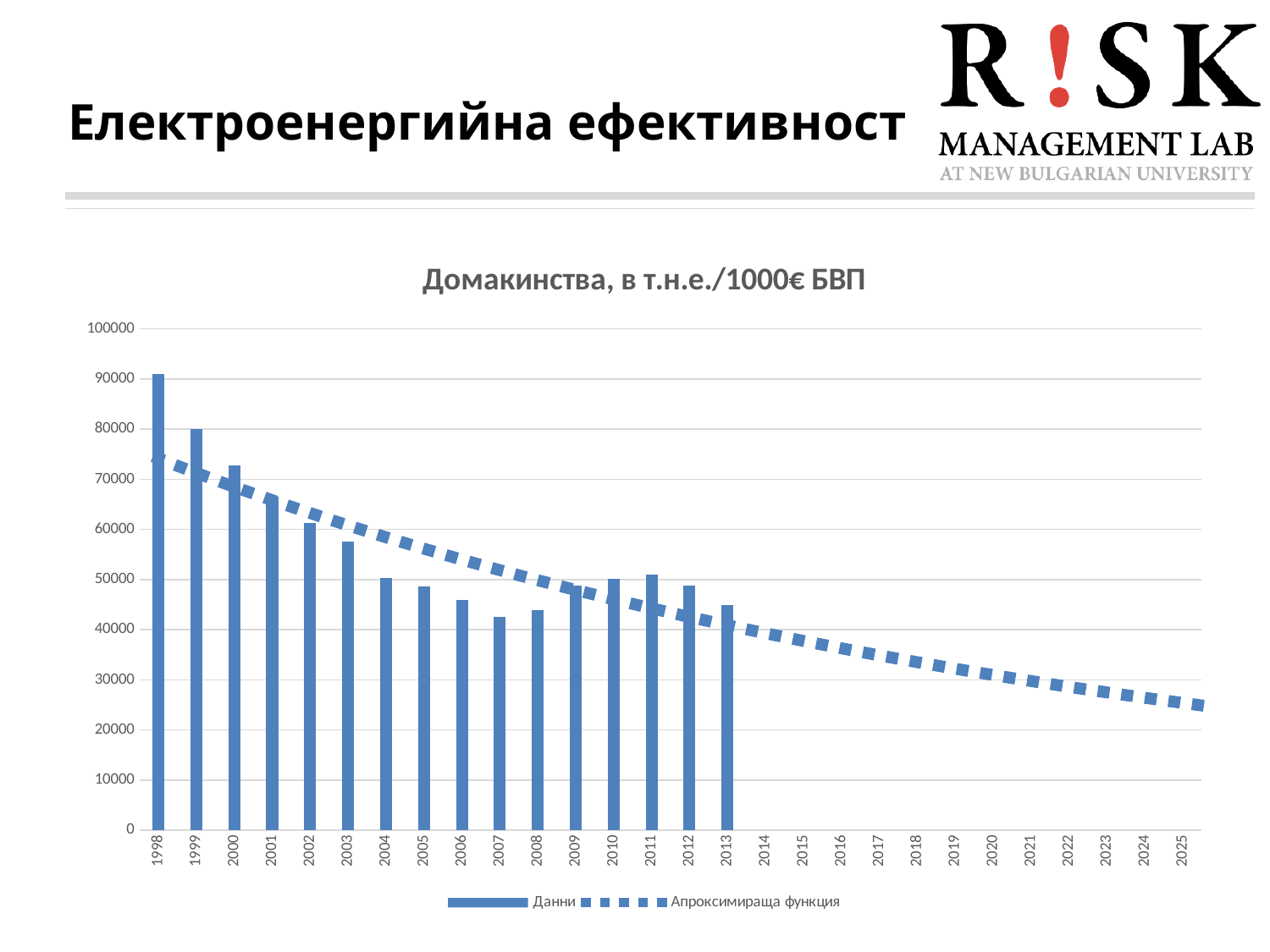
Is the value for 2003 greater or less than 60000? less What kind of chart is shown on the slide? bar chart What is the title of the chart? Домакинства, в т.н.е./1000€ БВП Is the value for 1998 greater or less than 80000? greater Which year has the lowest bar? 2007 How many series does the legend list? 2 What are the two entries in the chart legend? Данни and Апроксимираща функция How many years have a bar plotted in the chart? 16 Which year has the highest bar? 1998 Do the bar values generally rise or fall from 1998 to 2013? fall Is the value for 2007 greater or less than 50000? less Which is larger, the bar for 2011 or the bar for 2012? 2011